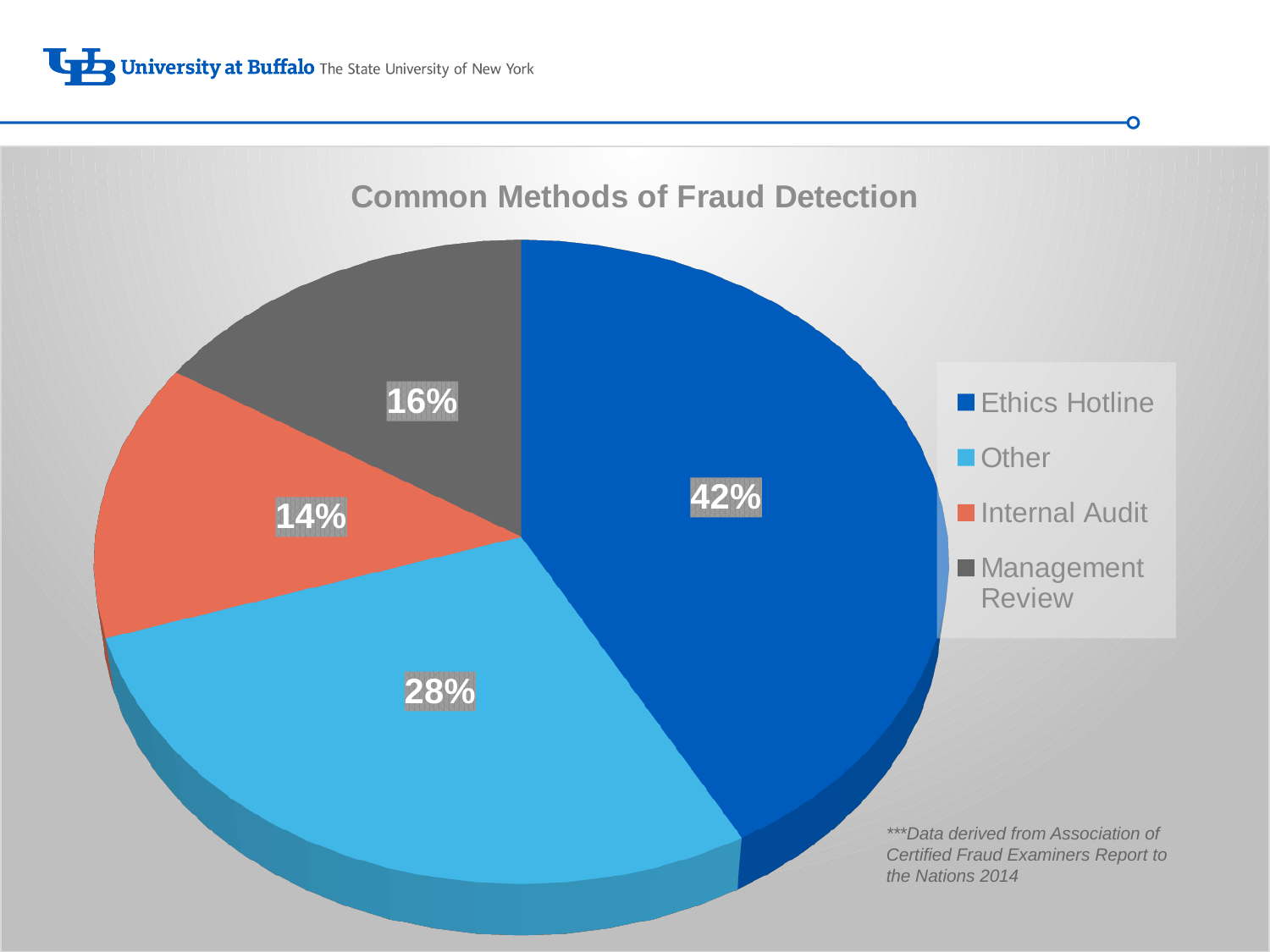
What is the difference between the Ethics Hotline and Other shares? 14% What kind of chart is shown on the slide? pie chart What share of the pie does Ethics Hotline account for? 42% What is the value shown for Internal Audit? 14% What colour is the Internal Audit slice? red What is the value shown for Management Review? 16% What is the title of the chart? Common Methods of Fraud Detection Which method has the smallest slice of the pie? Internal Audit Which method has the largest slice of the pie? Ethics Hotline What is the value shown for Other? 28% How many categories does the pie chart show? 4 Which is larger, the share for Management Review or the share for Internal Audit? Management Review